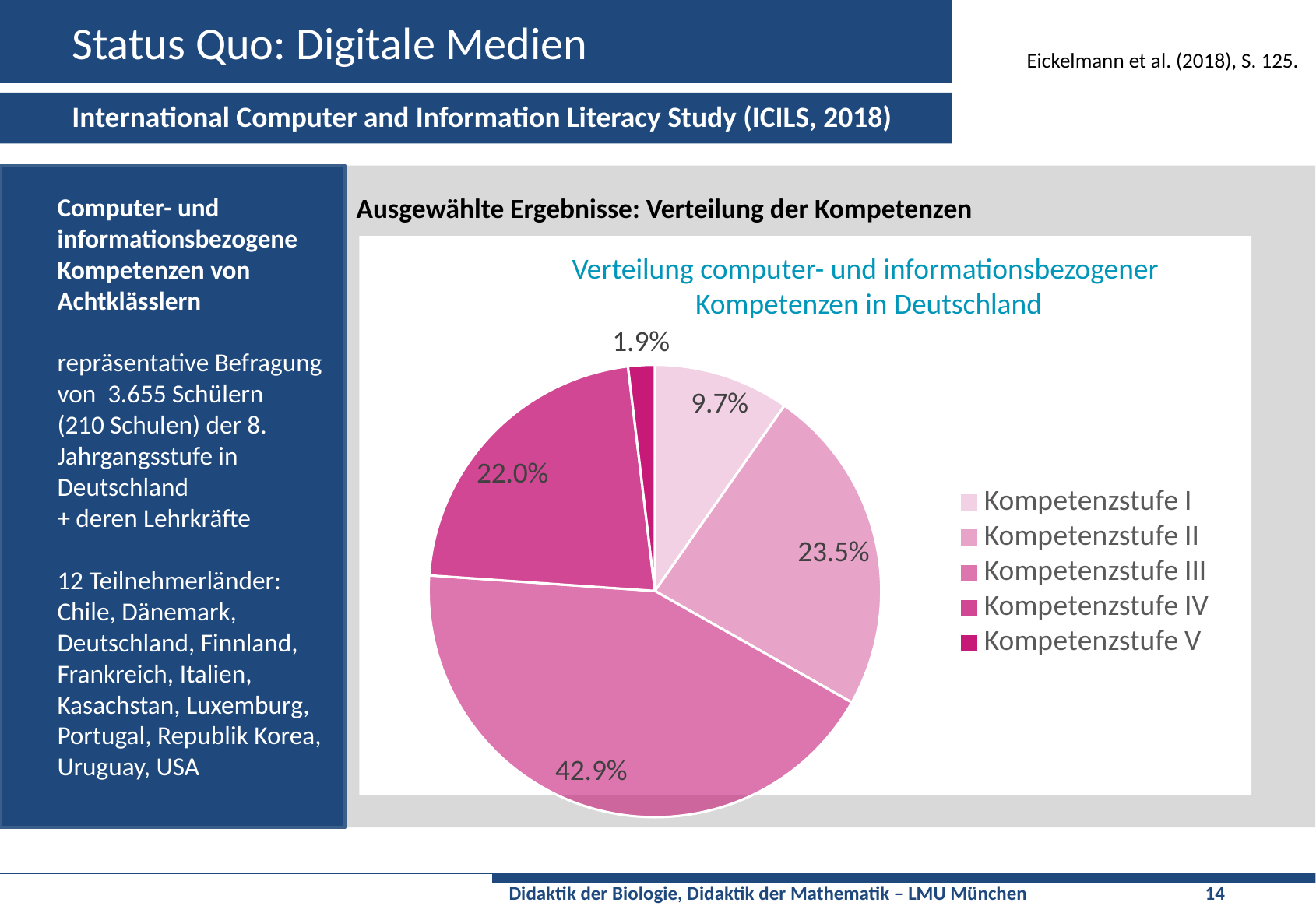
What is the share for Kompetenzstufe I? 9.7% What is the share for Kompetenzstufe II? 23.5% What type of chart is shown on the slide? pie chart What is the share for Kompetenzstufe III? 42.9% Which Kompetenzstufe has the smallest share of the pie? Kompetenzstufe V How many slices does the pie chart have? 5 Which has a larger share, Kompetenzstufe II or Kompetenzstufe IV? Kompetenzstufe II What is the difference between the shares of Kompetenzstufe III and Kompetenzstufe II? 19.4% What is the share for Kompetenzstufe V? 1.9% What is the title of the pie chart? Verteilung computer- und informationsbezogener Kompetenzen in Deutschland Which Kompetenzstufe has the largest share of the pie? Kompetenzstufe III How many entries does the legend list? 5